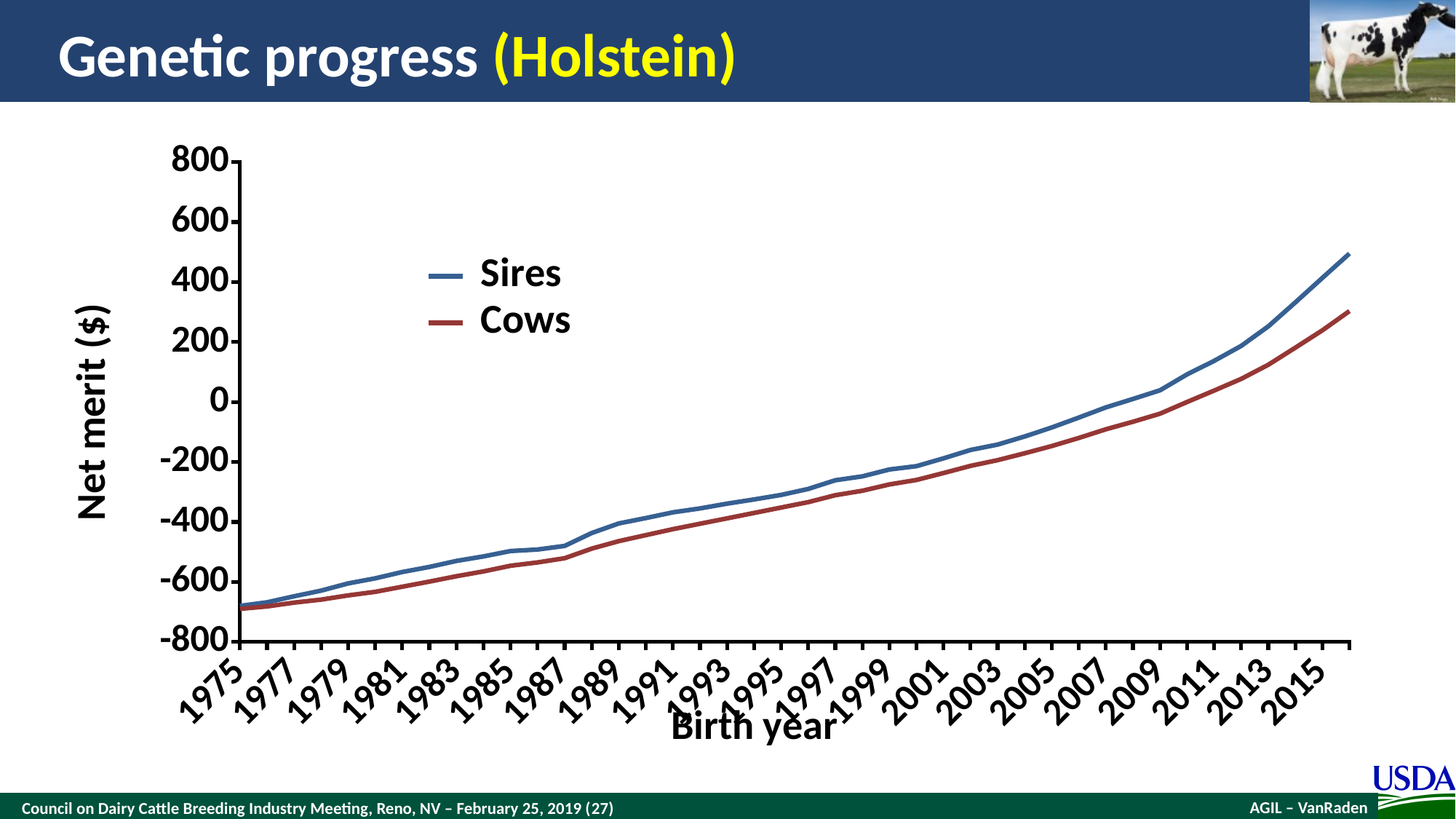
Is the Sires value for birth year 2009 greater or less than -200? greater Which series has the higher net merit for birth year 2015, Sires or Cows? Sires Is the Cows value for birth year 2015 greater or less than 0? greater How many series does the legend list? 2 Do the Sires values rise or fall from 1975 to 2015? rise How many birth-year labels are shown on the x axis? 21 Is the Sires value for birth year 1975 greater or less than -600? less Do the Cows values rise or fall along the birth-year axis? rise What kind of chart is shown on the slide? line chart What is the title of the y axis? Net merit ($) Which series is plotted in blue? Sires